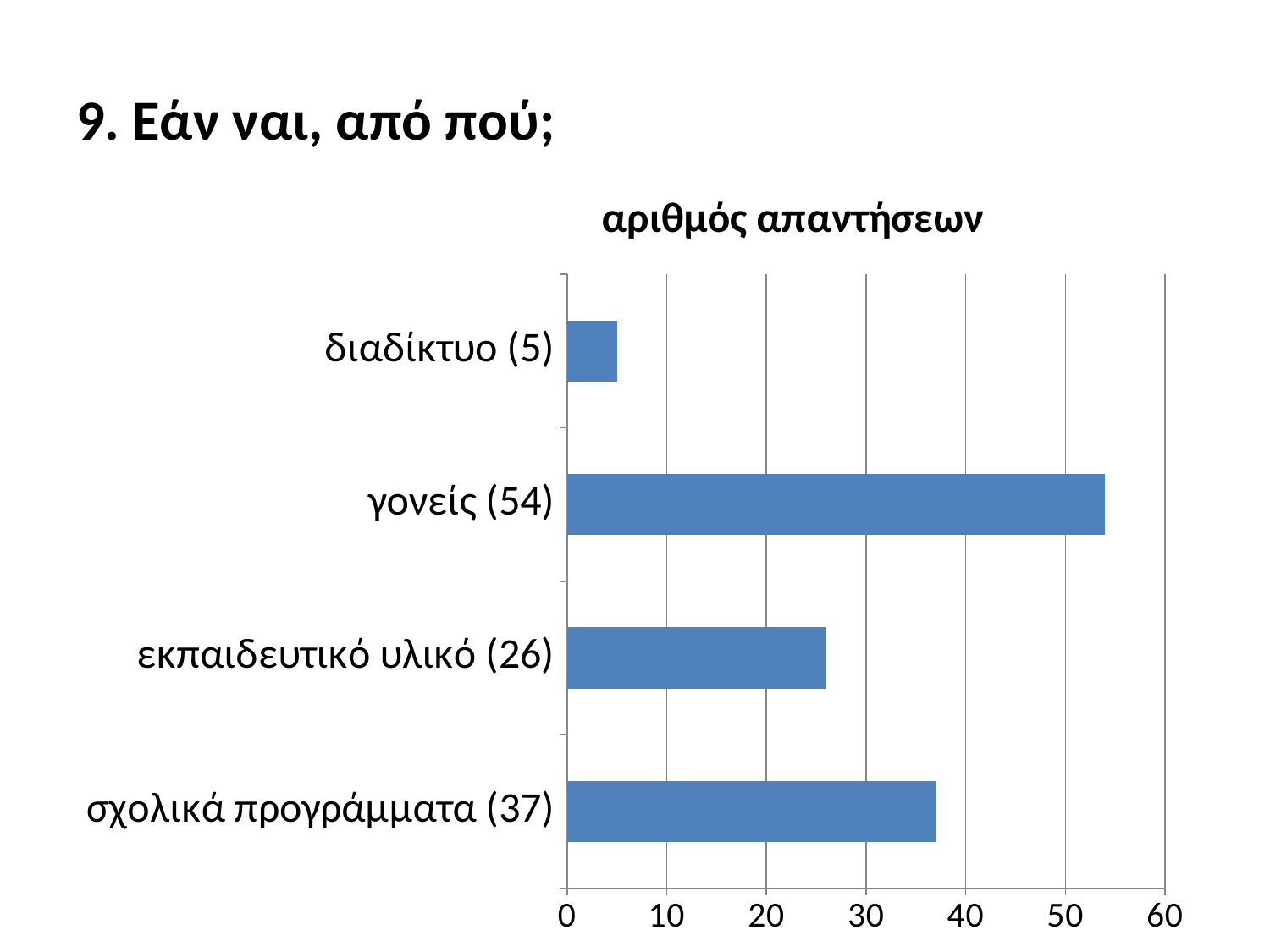
How many categories does the chart show? 4 What is the number of responses for διαδίκτυο? 5 Which category has the highest number of responses? γονείς What type of chart is shown on the slide? bar chart Is the value for γονείς greater or less than 50? greater What is the number of responses for σχολικά προγράμματα? 37 Which category has the lowest number of responses? διαδίκτυο What is the difference between the responses for γονείς and σχολικά προγράμματα? 17 Which has more responses, εκπαιδευτικό υλικό or σχολικά προγράμματα? σχολικά προγράμματα What is the number of responses for εκπαιδευτικό υλικό? 26 What is the number of responses for γονείς? 54 What is the chart's title? αριθμός απαντήσεων